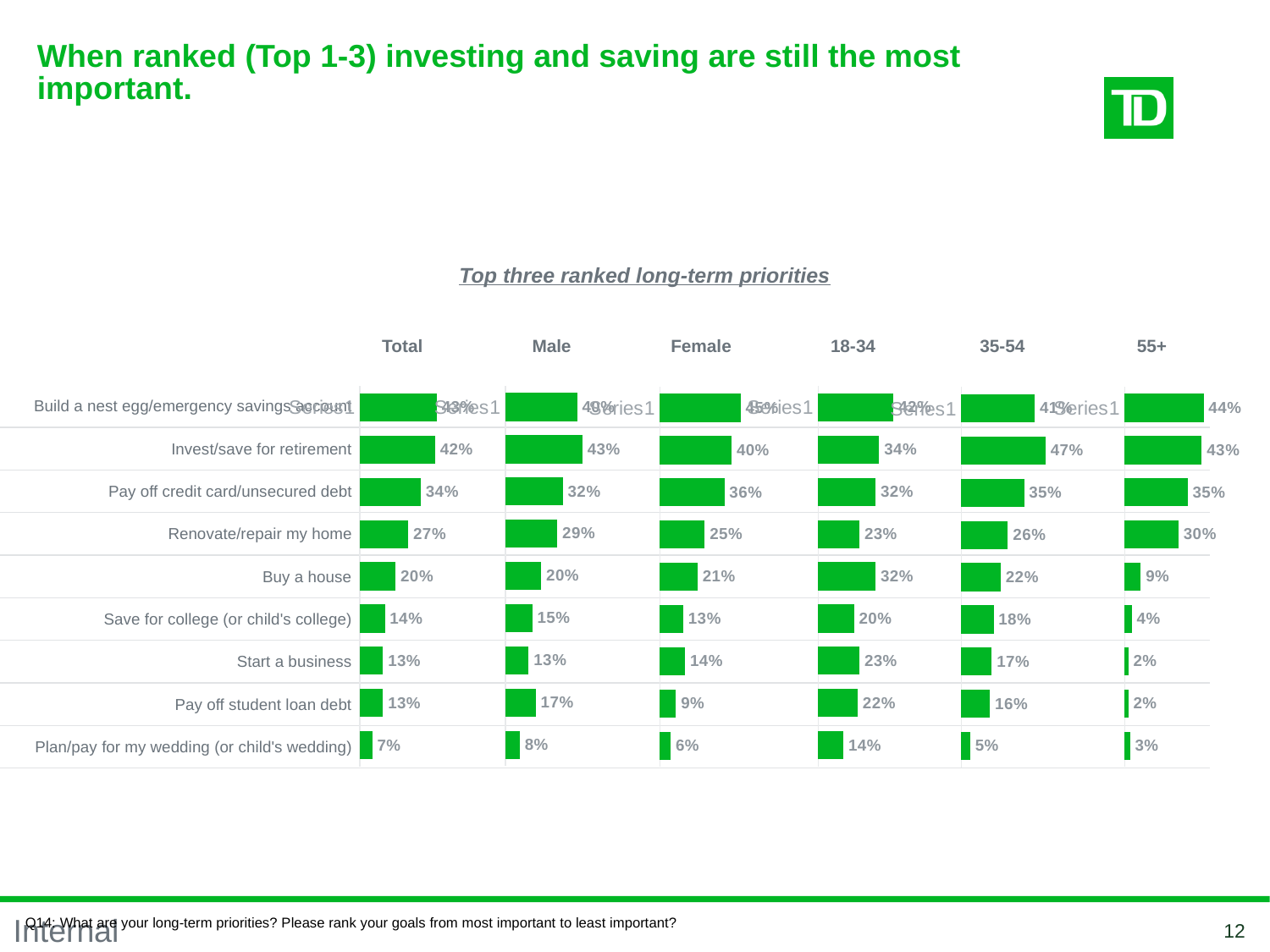
What is the title shown above the charts? Top three ranked long-term priorities In the 35-54 chart, what is the value for Invest/save for retirement? 47% How many categories are shown in each chart? 9 In the 55+ chart, what is the value for Build a nest egg/emergency savings account? 44% In the 18-34 chart, which is larger: Start a business or Pay off student loan debt? Start a business What kind of chart is used for each group on the slide? Bar chart In the Total chart, what is the value for Invest/save for retirement? 42% In the Female chart, what is the value for Pay off credit card/unsecured debt? 36% In the Male chart, what is the value for Pay off student loan debt? 17% In the Total chart, what is the difference between Invest/save for retirement and Pay off credit card/unsecured debt? 8% In the 55+ chart, which category has the lowest value? Start a business and Pay off student loan debt (2%) In the 18-34 chart, what is the value for Buy a house? 32%